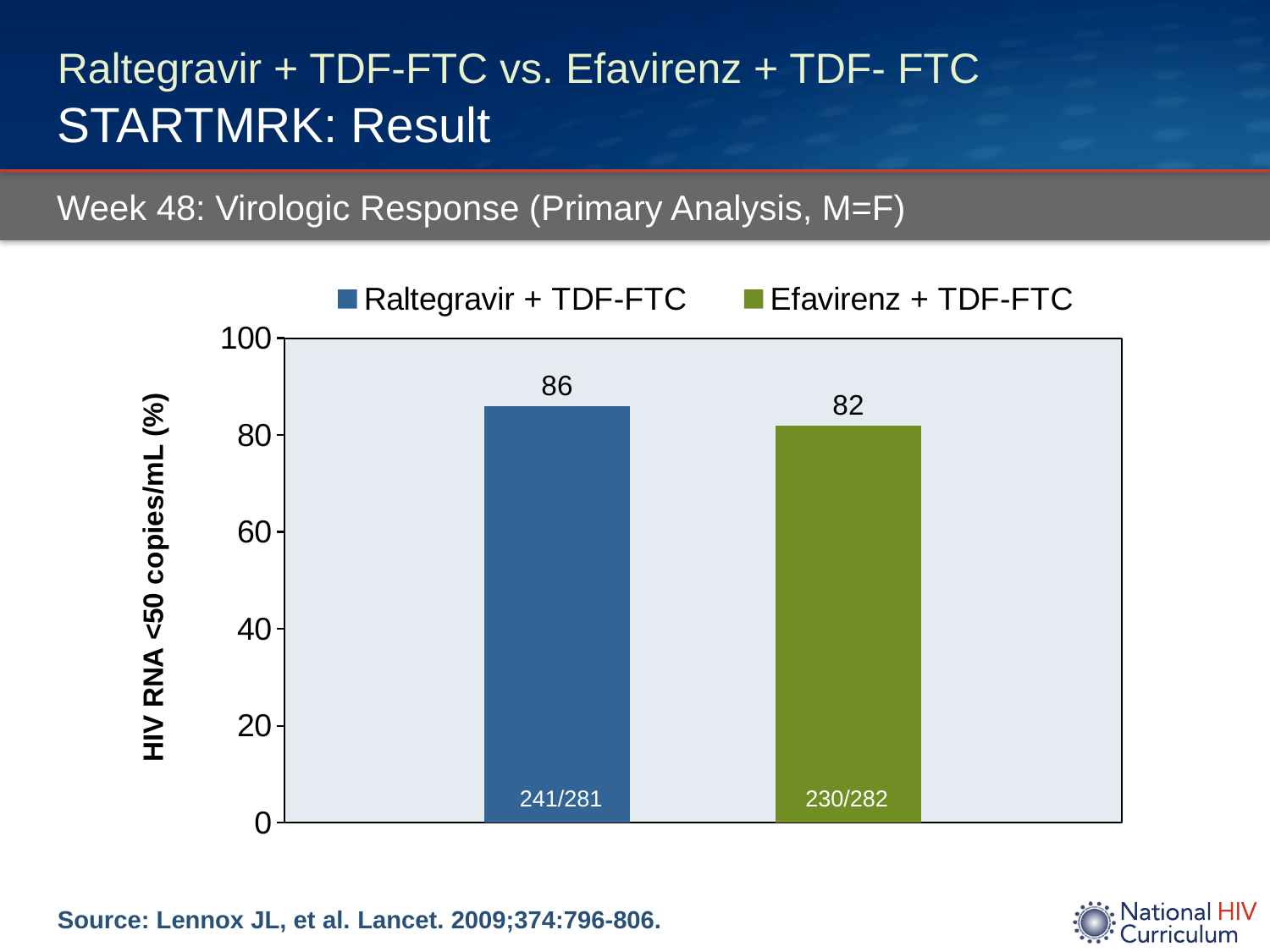
Which series has the higher value? Raltegravir + TDF-FTC Is the value for Efavirenz + TDF-FTC greater or less than 80? greater What kind of chart is shown on the slide? bar chart What is the value for Raltegravir + TDF-FTC? 86 What is the difference between the Raltegravir + TDF-FTC and Efavirenz + TDF-FTC values? 4 How many series does the legend list? 2 What fraction is printed inside the Raltegravir + TDF-FTC bar? 241/281 What is the value for Efavirenz + TDF-FTC? 82 Is the value for Raltegravir + TDF-FTC larger or smaller than the value for Efavirenz + TDF-FTC? larger Which series has the lower value? Efavirenz + TDF-FTC What is the label of the y axis? HIV RNA <50 copies/mL (%) How many bars are plotted in the chart? 2